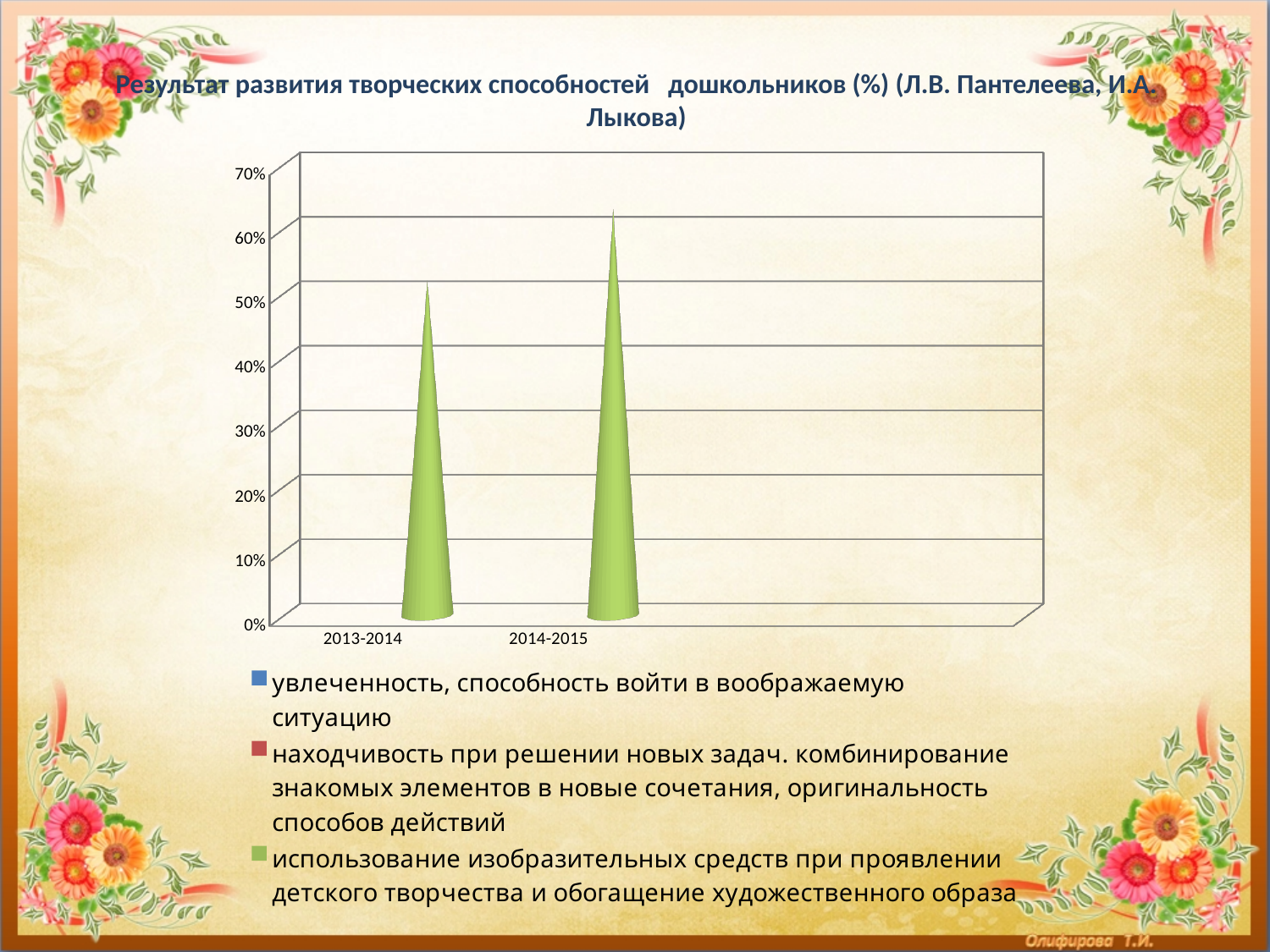
Which is larger, the value for 2013-2014 or the value for 2014-2015? 2014-2015 Do the values rise or fall from 2013-2014 to 2014-2015? rise Is the value for 2014-2015 greater or less than 70%? less What colour are the plotted bars in the chart? green How many categories are shown on the x axis of the chart? 2 Is the value for 2013-2014 greater or less than 40%? greater Is the value for 2013-2014 greater or less than 60%? less Which category has the lowest value in the chart? 2013-2014 Which category has the highest value in the chart? 2014-2015 What kind of chart is shown on the slide? bar chart How many series does the chart's legend list? 3